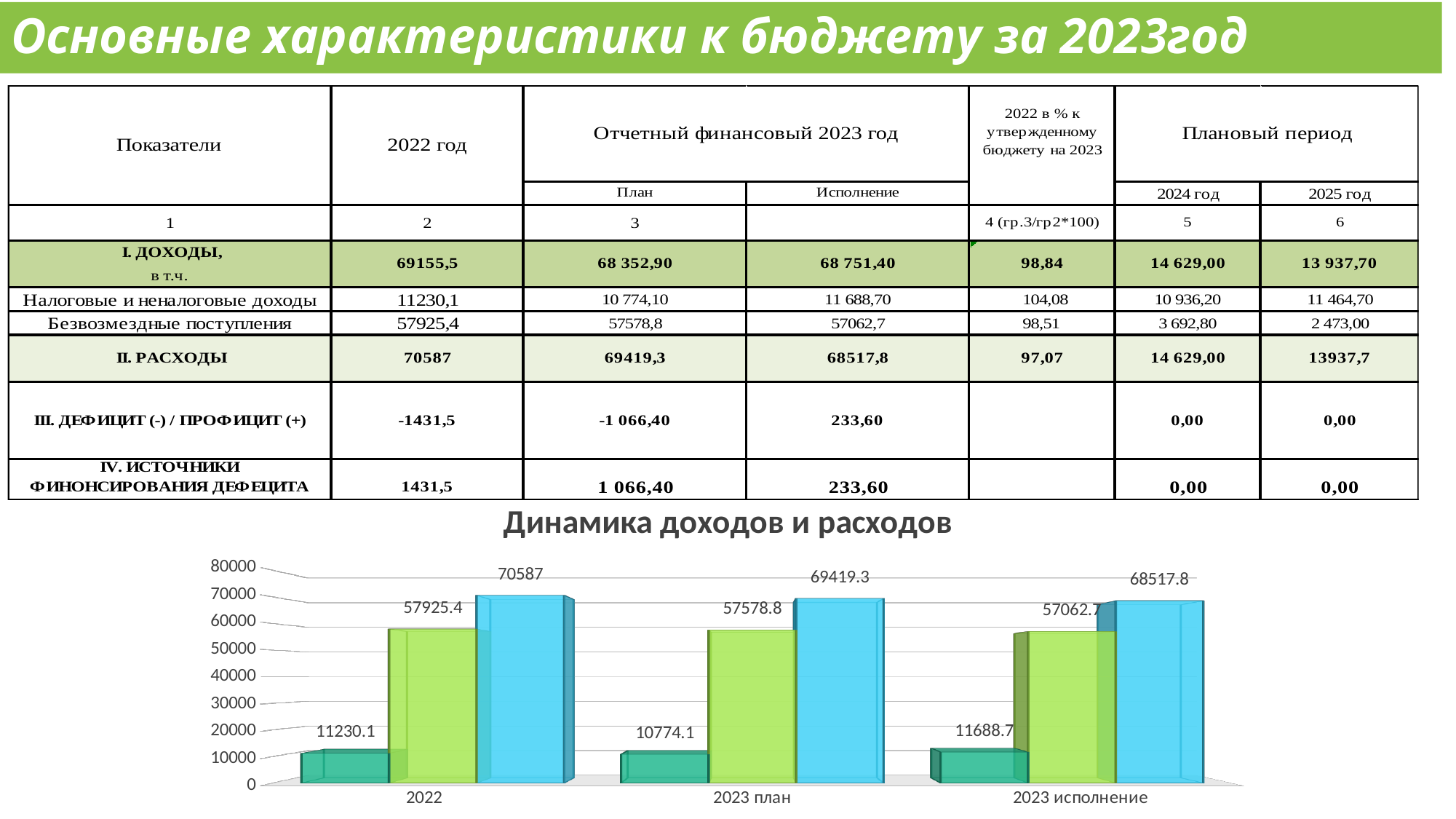
In the "Динамика доходов и расходов" chart, what is the difference between the blue bar and the green bar for 2022? 12661.6 What is the chart title of the chart at the bottom of the slide? Динамика доходов и расходов In the "Динамика доходов и расходов" chart, do the blue (third) bars rise or fall from 2022 to "2023 исполнение"? fall What kind of chart is shown under the title "Динамика доходов и расходов"? bar chart In the "Динамика доходов и расходов" chart, which category has the highest blue (third) bar? 2022 In the "Динамика доходов и расходов" chart, which is larger: the teal bar for 2022 or the teal bar for "2023 исполнение"? 2023 исполнение In the "Динамика доходов и расходов" chart, what is the value of the green (middle) bar for "2023 план"? 57578.8 In the "Динамика доходов и расходов" chart, what is the value of the teal (first) bar for "2023 исполнение"? 11688.7 In the "Динамика доходов и расходов" chart, what is the value of the tallest (blue) bar for 2022? 70587 How many categories are shown on the x axis of the "Динамика доходов и расходов" chart? 3 In the "Динамика доходов и расходов" chart, which category has the lowest teal (first) bar? 2023 план In the "Динамика доходов и расходов" chart, what is the difference between the blue bar for "2023 план" and the blue bar for "2023 исполнение"? 901.5